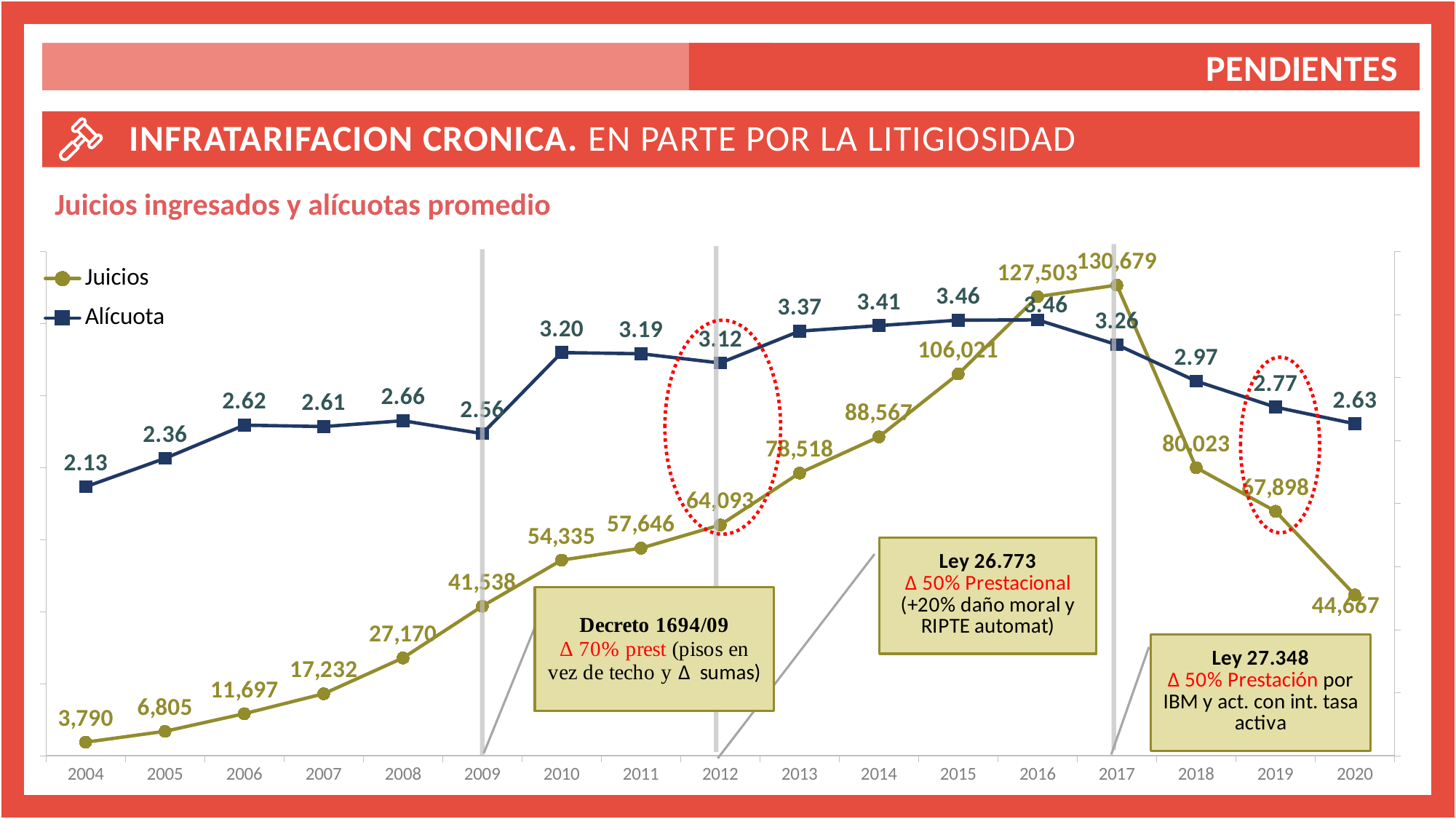
What is the Alícuota value in 2004? 2.13 What is the difference between the Juicios values in 2017 and 2016? 3,176 What type of chart is shown on the slide? Line chart In which year is the Juicios series at its lowest? 2004 How many years are shown on the x axis? 17 How many series does the legend list? 2 In which year is the Juicios series at its highest? 2017 What is the value of Juicios in 2017? 130,679 What is the Alícuota value in 2019? 2.77 Which is larger, the Alícuota value in 2010 or in 2018? 2010 What is the value of Juicios in 2020? 44,667 What is the title of the chart? Juicios ingresados y alícuotas promedio